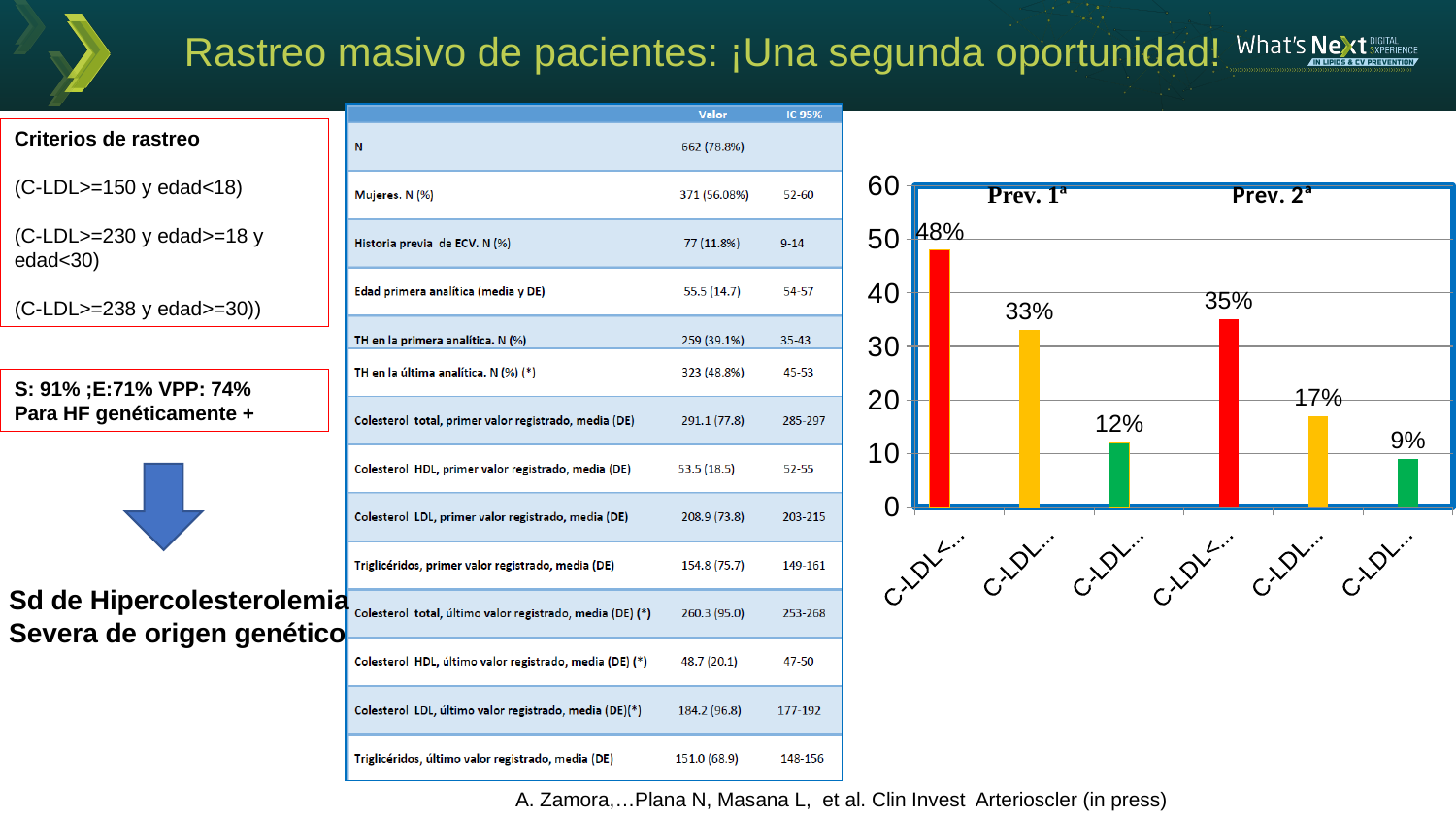
Which is larger: the yellow bar in the Prev. 1ª group or the yellow bar in the Prev. 2ª group? The yellow bar in the Prev. 1ª group What is the highest value shown in the chart? 48% How many bars are plotted in the chart? 6 What is the value of the yellow bar in the Prev. 2ª group? 17% What is the difference between the red bar in the Prev. 1ª group (48%) and the red bar in the Prev. 2ª group (35%)? 13 percentage points What is the value of the green bar in the Prev. 1ª group? 12% What is the value of the red bar in the Prev. 1ª group? 48% Is the value of the first (red) bar in the chart greater or less than 40? greater What kind of chart is shown on the right side of the slide? Bar chart Within the Prev. 2ª group, do the bar values rise or fall from left to right? Fall What are the two group labels printed at the top of the chart? Prev. 1ª and Prev. 2ª What is the lowest value shown in the chart? 9%